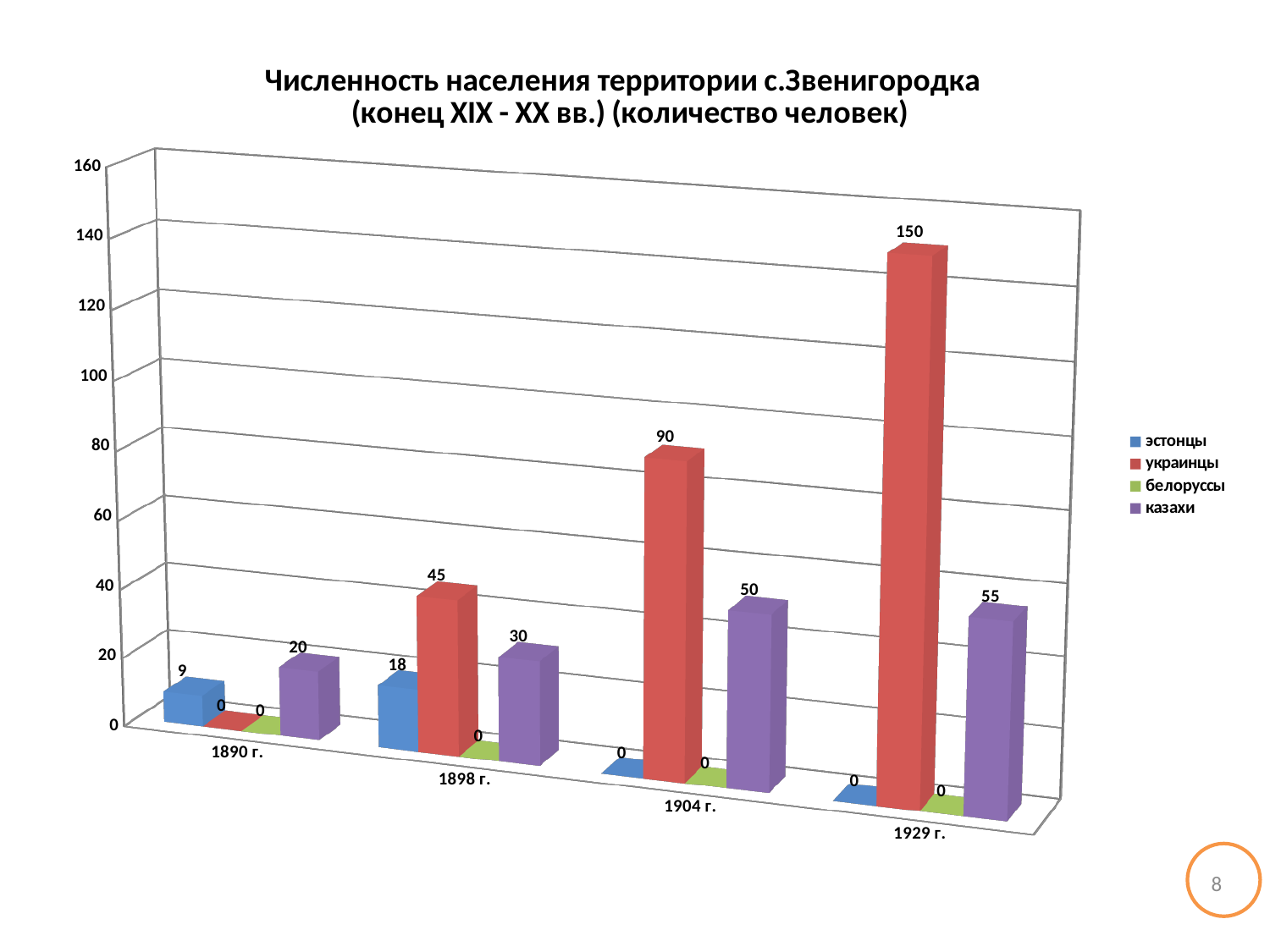
What is the value for эстонцы in 1898 г.? 18 In which year is the value for казахи lowest? 1890 г. What is the value for украинцы in 1929 г.? 150 In which year is the value for украинцы highest? 1929 г. Which colour represents белоруссы in the legend? green How many series does the legend list? 4 What kind of chart is shown on the slide? bar chart What is the value for казахи in 1904 г.? 50 What is the difference between the украинцы values in 1929 г. and 1904 г.? 60 How many years are shown on the x axis? 4 Which is larger in 1898 г.: the value for украинцы or the value for казахи? украинцы Do the values for украинцы rise or fall from 1890 г. to 1929 г.? rise